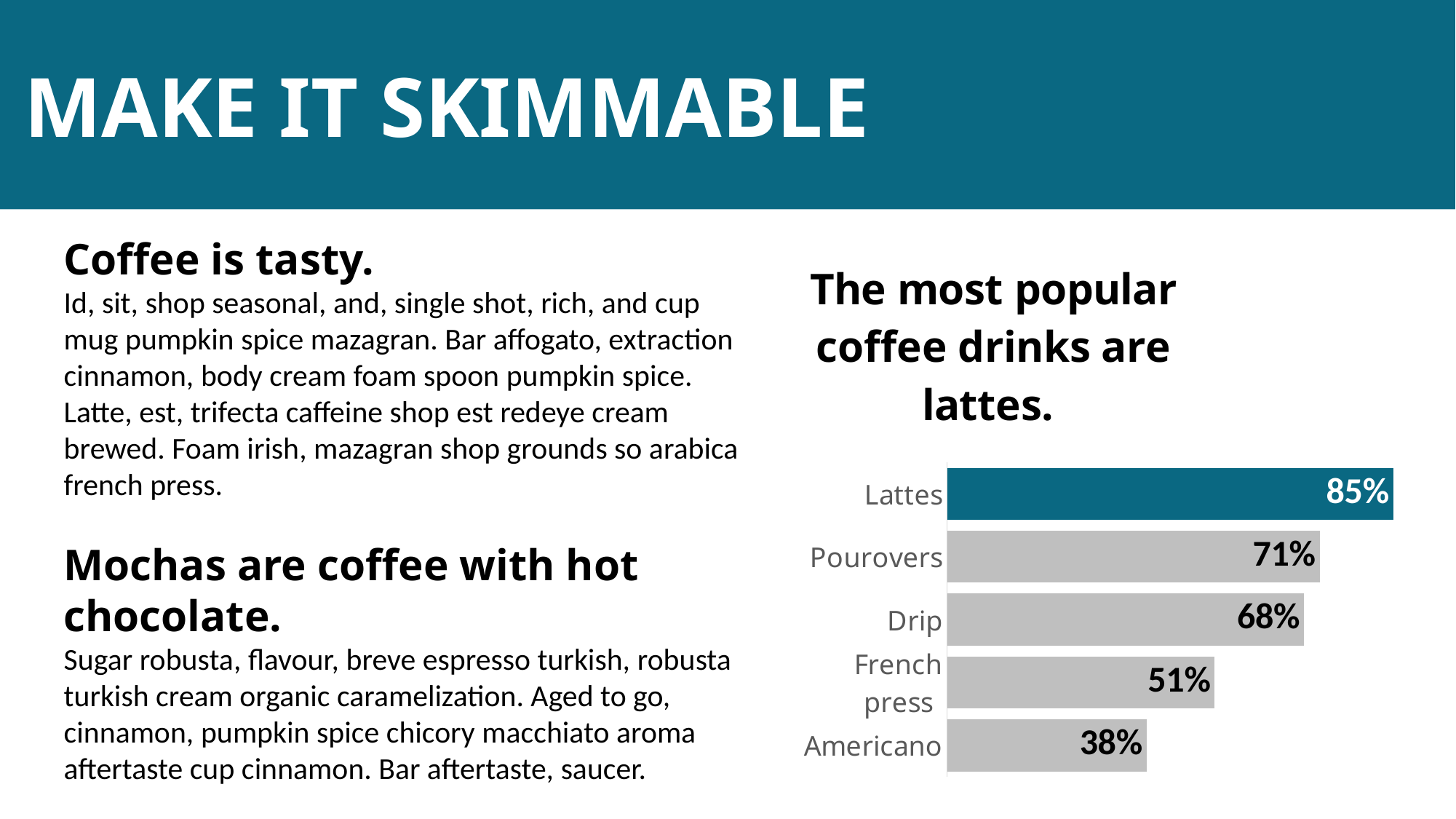
Which coffee drink has the highest value? Lattes What is the title of the chart? The most popular coffee drinks are lattes. What is the value for French press? 51% What is the value for Pourovers? 71% Which has a larger value, Drip or French press? Drip What is the value for Lattes? 85% What is the difference between the values for Lattes and Americano? 47% Which coffee drink has the lowest value? Americano What is the value for Americano? 38% What is the difference between the values for Pourovers and Drip? 3% What kind of chart is shown on the slide? Bar chart How many coffee drinks are shown in the chart? 5